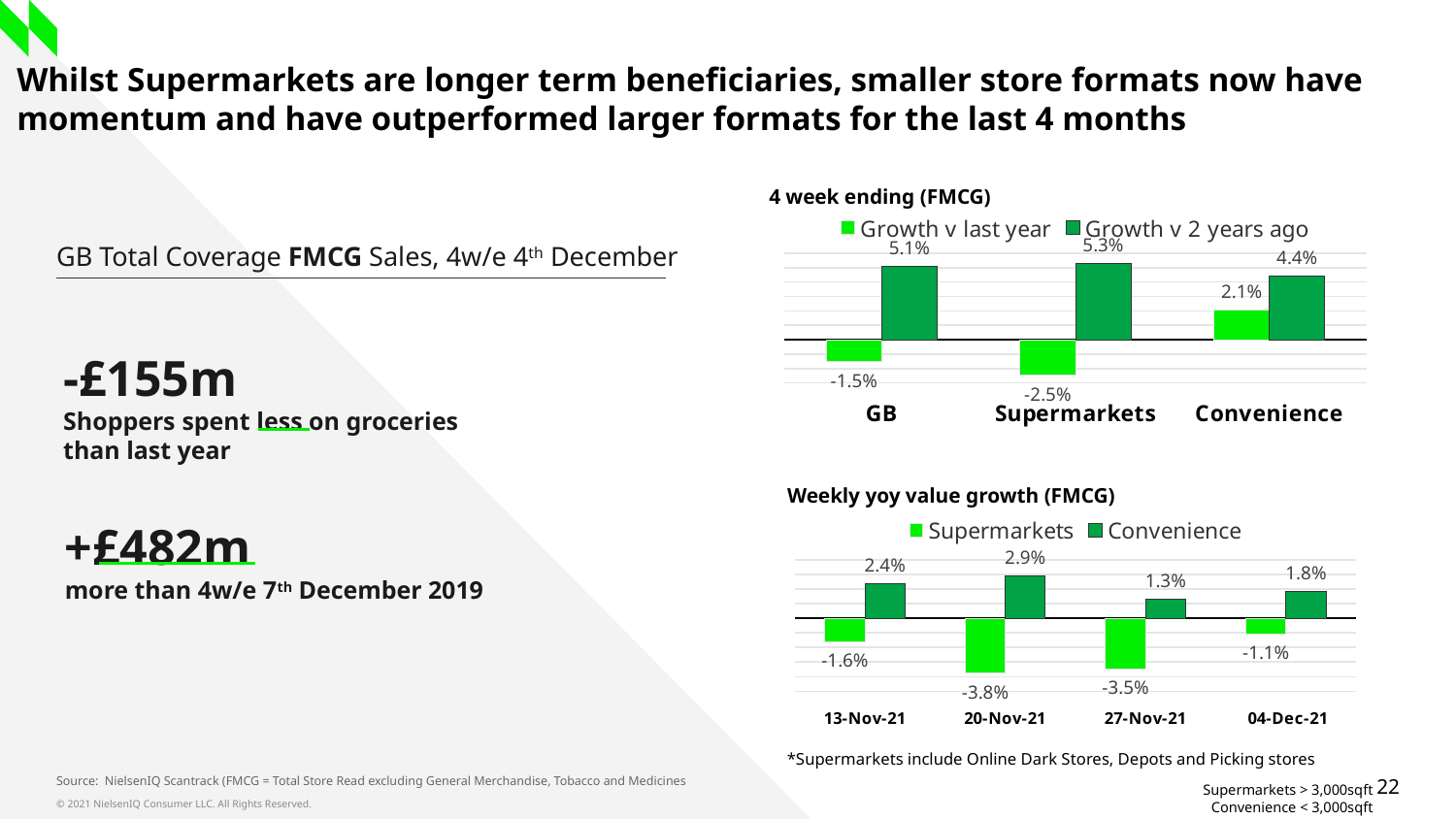
In the 'Weekly yoy value growth (FMCG)' chart, what is the Convenience value for 04-Dec-21? 1.8% In the '4 week ending (FMCG)' chart, what is the Growth v last year value for Supermarkets? -2.5% What kind of chart is the 'Weekly yoy value growth (FMCG)' chart? bar chart In the 'Weekly yoy value growth (FMCG)' chart, what is the Supermarkets value for 20-Nov-21? -3.8% In the '4 week ending (FMCG)' chart, what is the Growth v 2 years ago value for Convenience? 4.4% In the 'Weekly yoy value growth (FMCG)' chart, is the Convenience value for 27-Nov-21 larger or smaller than the Convenience value for 13-Nov-21? smaller In the '4 week ending (FMCG)' chart, which category has the highest Growth v 2 years ago? Supermarkets In the 'Weekly yoy value growth (FMCG)' chart, how many weeks are shown on the x axis? 4 In the '4 week ending (FMCG)' chart, which category has the lowest Growth v last year? Supermarkets In the '4 week ending (FMCG)' chart, how many series does the legend list? 2 In the '4 week ending (FMCG)' chart, what is the difference between Growth v 2 years ago and Growth v last year for GB? 6.6 percentage points In the 'Weekly yoy value growth (FMCG)' chart, which week has the highest Convenience value? 20-Nov-21